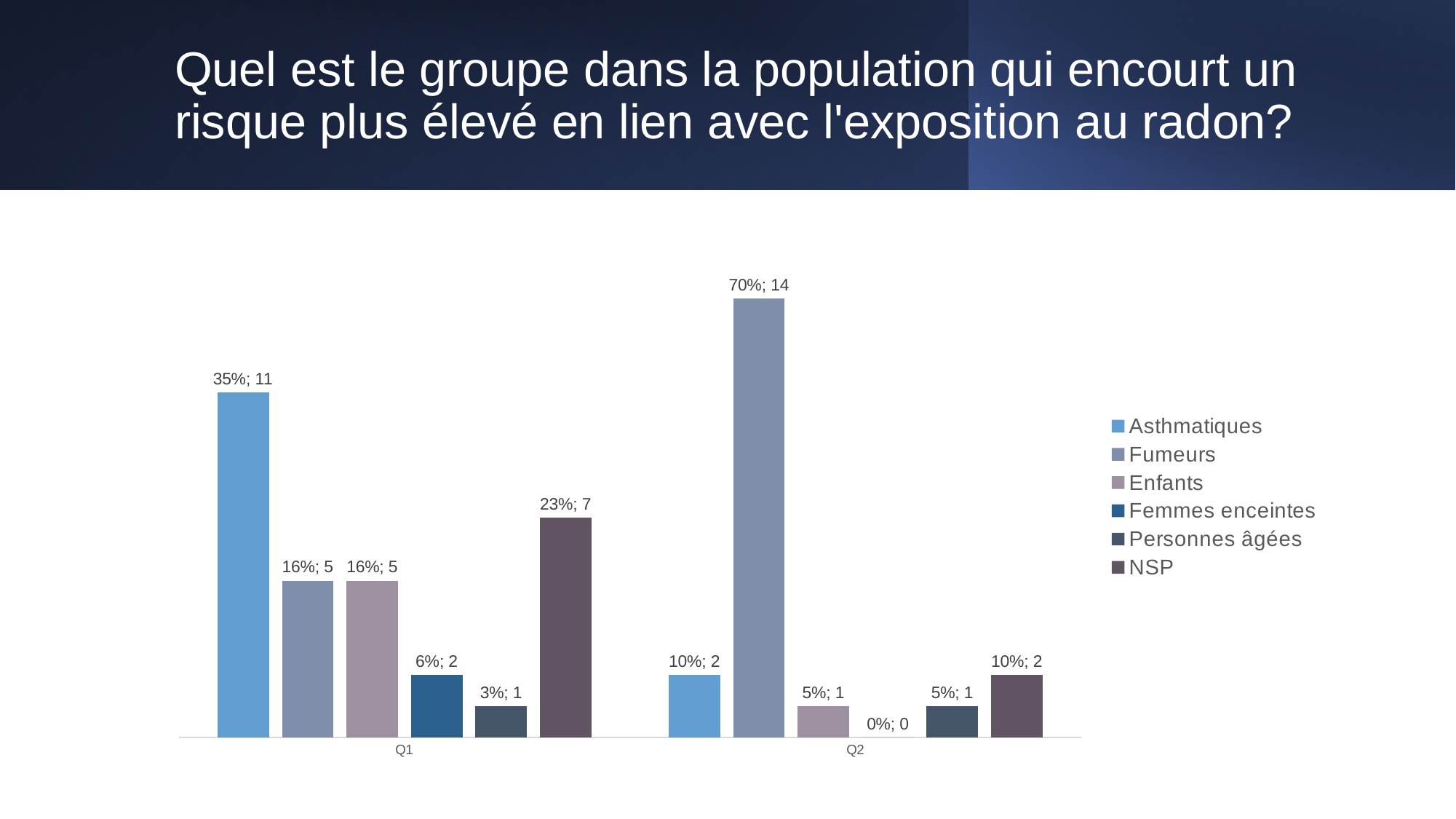
What is the data label for NSP in Q1? 23%; 7 What is the difference in count between Asthmatiques and Fumeurs in Q1? 6 Which series has the lowest value in Q1? Personnes âgées What is the data label for Asthmatiques in Q1? 35%; 11 How many categories are shown on the x axis? 2 Which series has the highest value in Q2? Fumeurs Does the value for Asthmatiques rise or fall from Q1 to Q2? Fall What is the data label for Fumeurs in Q2? 70%; 14 How many series does the legend list? 6 Which is larger in Q1: the value for NSP or the value for Enfants? NSP What is the data label for Femmes enceintes in Q2? 0%; 0 What kind of chart is shown on the slide? Bar chart